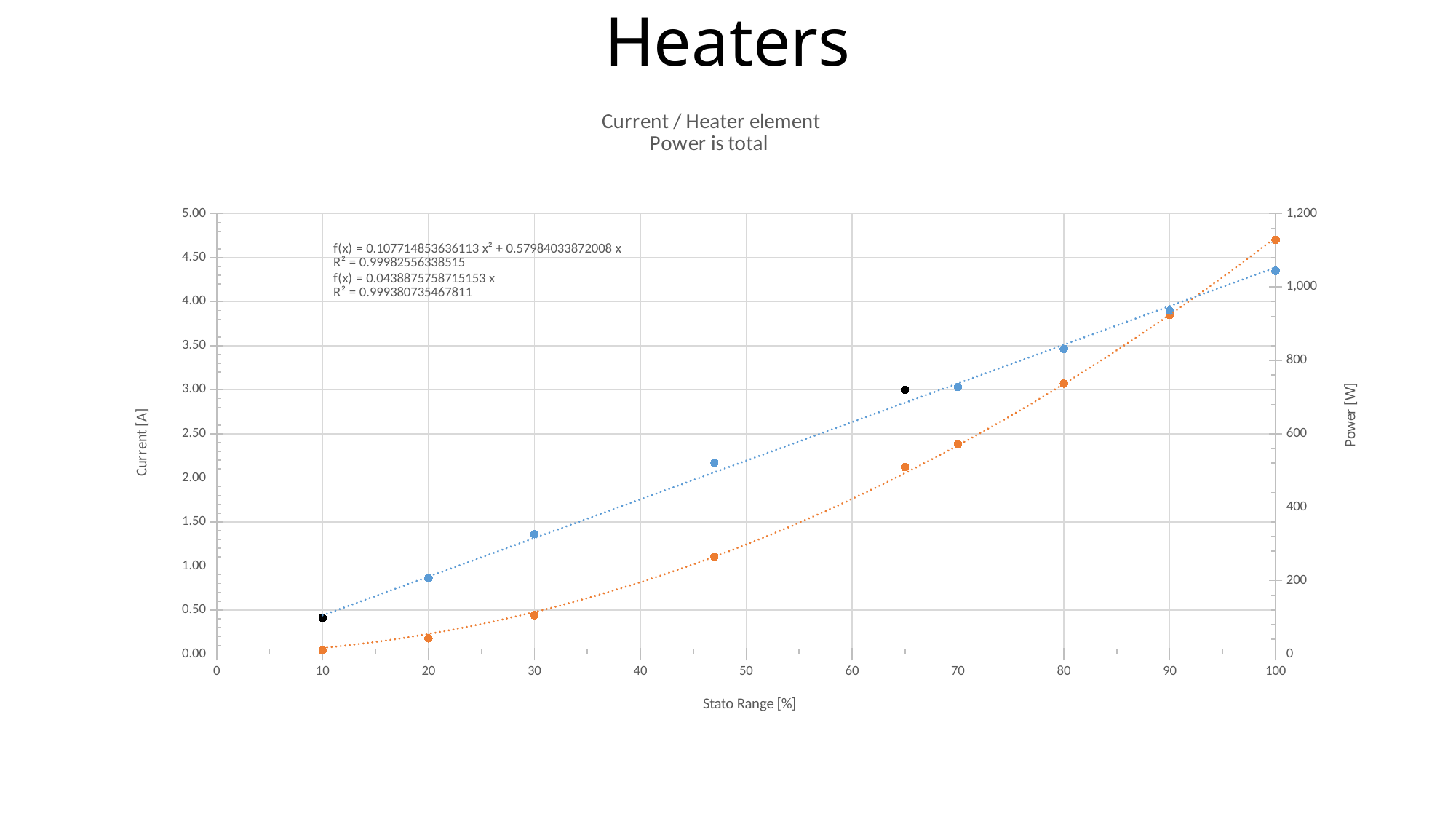
What is the title of the chart? Current / Heater element Power is total Is the blue current value at Stato Range 100 greater or less than 4.00 A? greater Is the orange power value at Stato Range 100 greater or less than 1,000 W? greater Do the blue current values rise or fall as Stato Range increases? rise What kind of chart is shown on the slide? scatter chart Is the orange power value at Stato Range 80 greater or less than 600 W? greater What is the label of the x axis? Stato Range [%] Do the orange power values rise or fall as Stato Range increases? rise At which Stato Range value is the blue current highest? 100